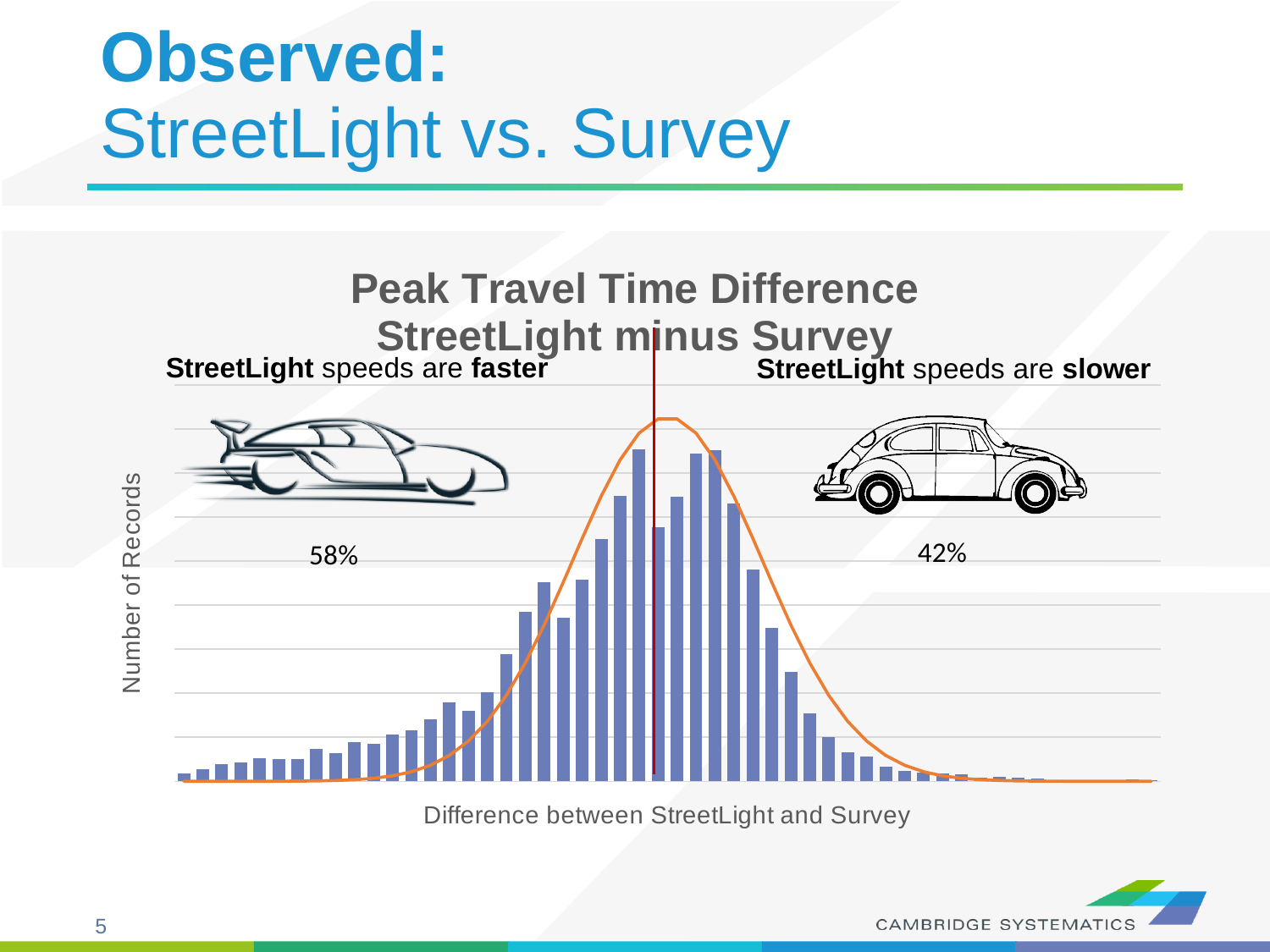
What is the difference between the percentage shown for StreetLight speeds faster and the percentage shown for StreetLight speeds slower? 16% Which side of the chart has the larger share of records: StreetLight speeds faster or StreetLight speeds slower? StreetLight speeds are faster What do the two percentages shown on the chart (58% and 42%) add up to? 100% What is the label on the vertical axis of the chart? Number of Records What percentage is shown on the side of the chart where StreetLight speeds are faster? 58% Do the bar heights rise or fall moving from the left edge of the chart toward the vertical red line? rise What percentage is shown on the side of the chart where StreetLight speeds are slower? 42% What is the title of the chart? Peak Travel Time Difference StreetLight minus Survey Do the bar heights rise or fall moving from the vertical red line toward the right edge of the chart? fall What kind of chart is shown on the slide? combination bar and line chart (bars with an overlaid curve)